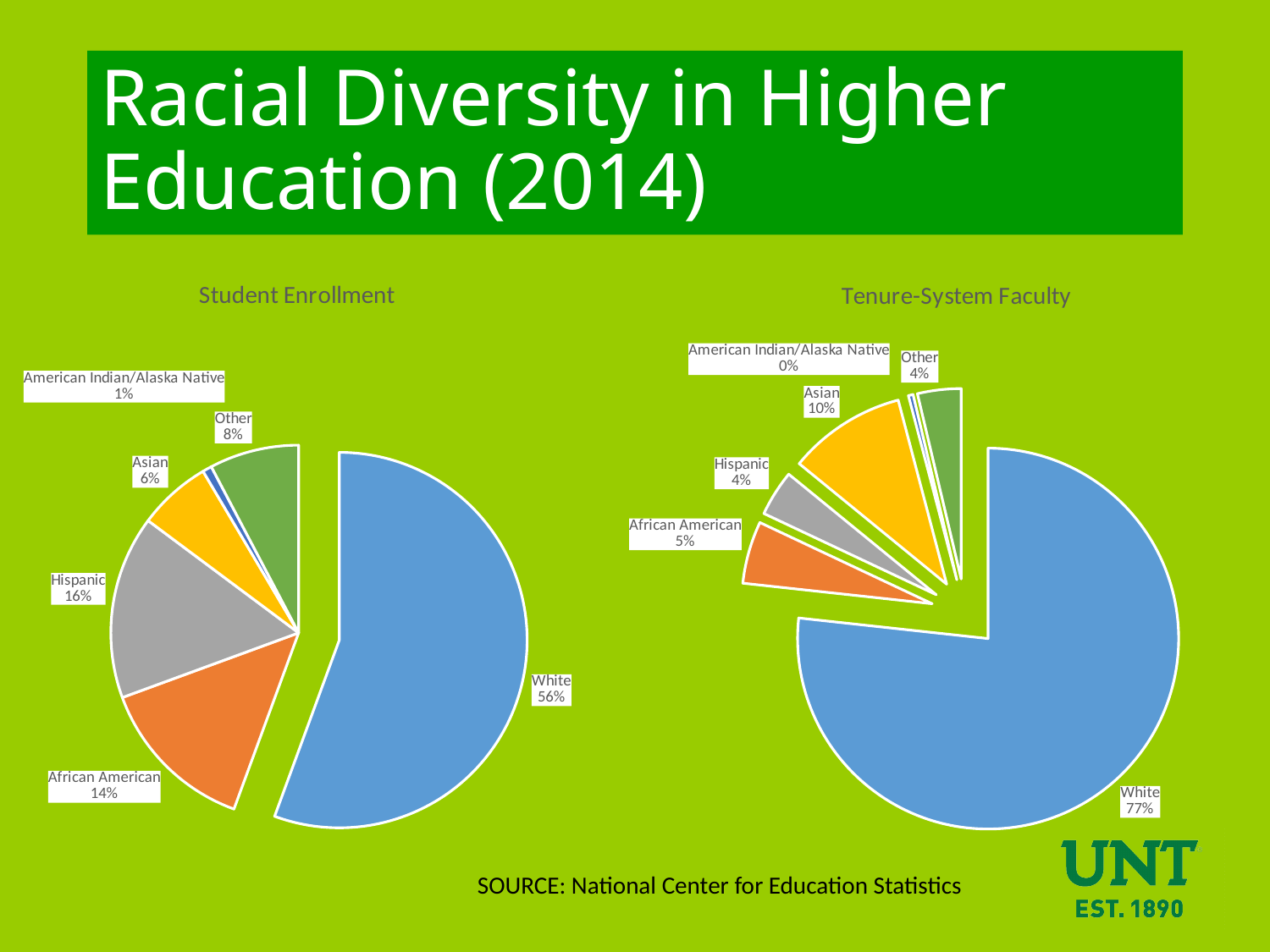
In the Student Enrollment chart, what share is White? 56% In the Student Enrollment chart, which category has the largest share? White In the Student Enrollment chart, what is the difference between the Other share and the Asian share? 2% In the Student Enrollment chart, which is larger: the Hispanic share or the African American share? Hispanic In the Student Enrollment chart, what percentage is Hispanic? 16% What is the difference between the White share in the Tenure-System Faculty chart and the White share in the Student Enrollment chart? 21% In the Tenure-System Faculty chart, which category has the smallest share? American Indian/Alaska Native In the Tenure-System Faculty chart, what share is White? 77% What type of chart is the Tenure-System Faculty chart? Pie chart How many categories are shown in the Student Enrollment chart? 6 What is the title of the chart on the left side of the slide? Student Enrollment In the Tenure-System Faculty chart, what percentage is Asian? 10%